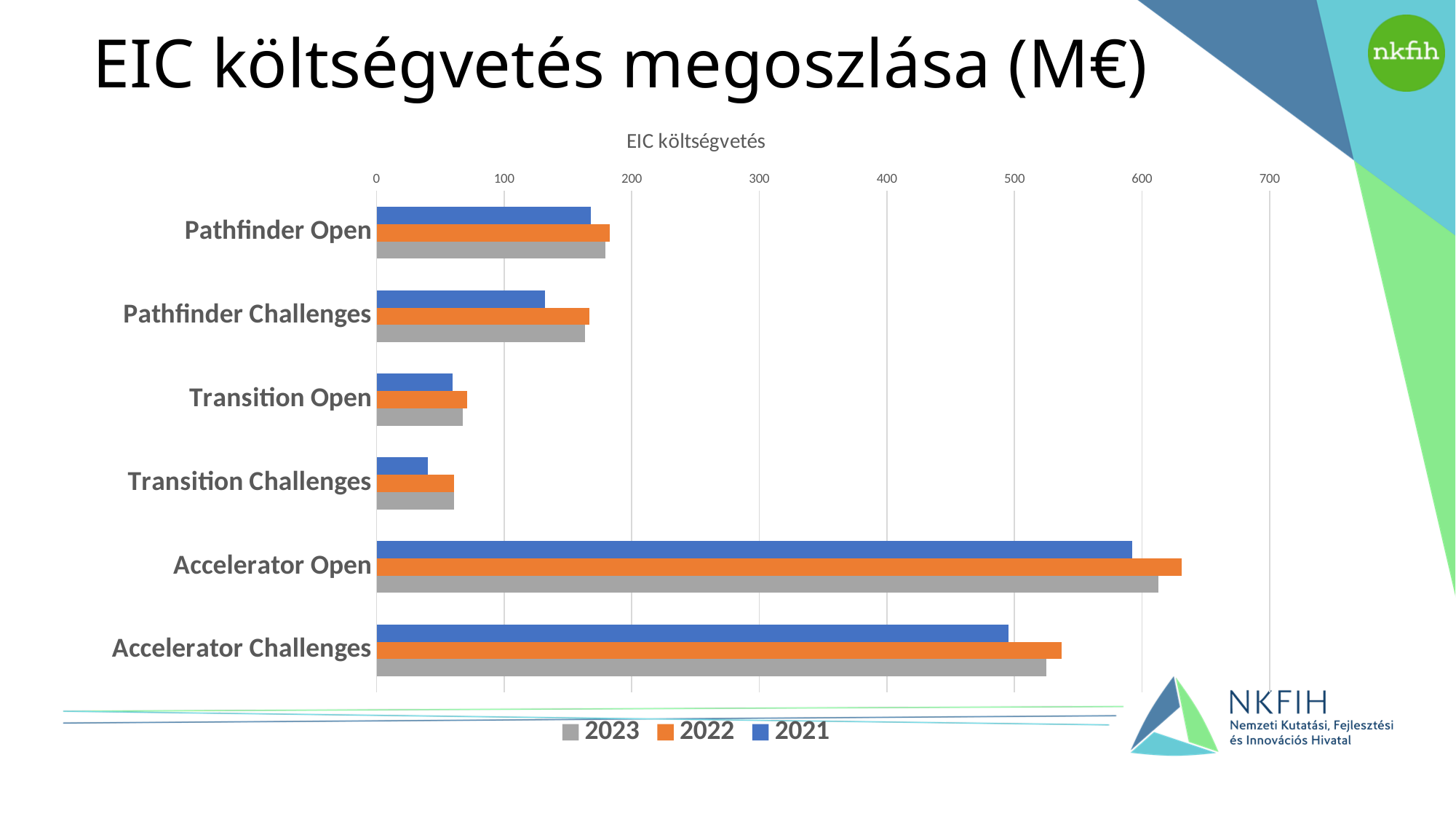
Which category has the lowest value for 2021? Transition Challenges For Accelerator Open, which year has the larger value: 2021 or 2022? 2022 What is the title of the chart? EIC költségvetés How many categories are shown on the chart? 6 Is the 2022 value for Transition Open greater or less than 100? less Is the 2022 value for Accelerator Open greater or less than 600? greater Is the 2021 value for Accelerator Challenges greater or less than 400? greater Which category has the highest value for 2022? Accelerator Open How many series does the legend list? 3 What kind of chart is shown on the slide? bar chart Which is larger for 2021: Pathfinder Open or Pathfinder Challenges? Pathfinder Open